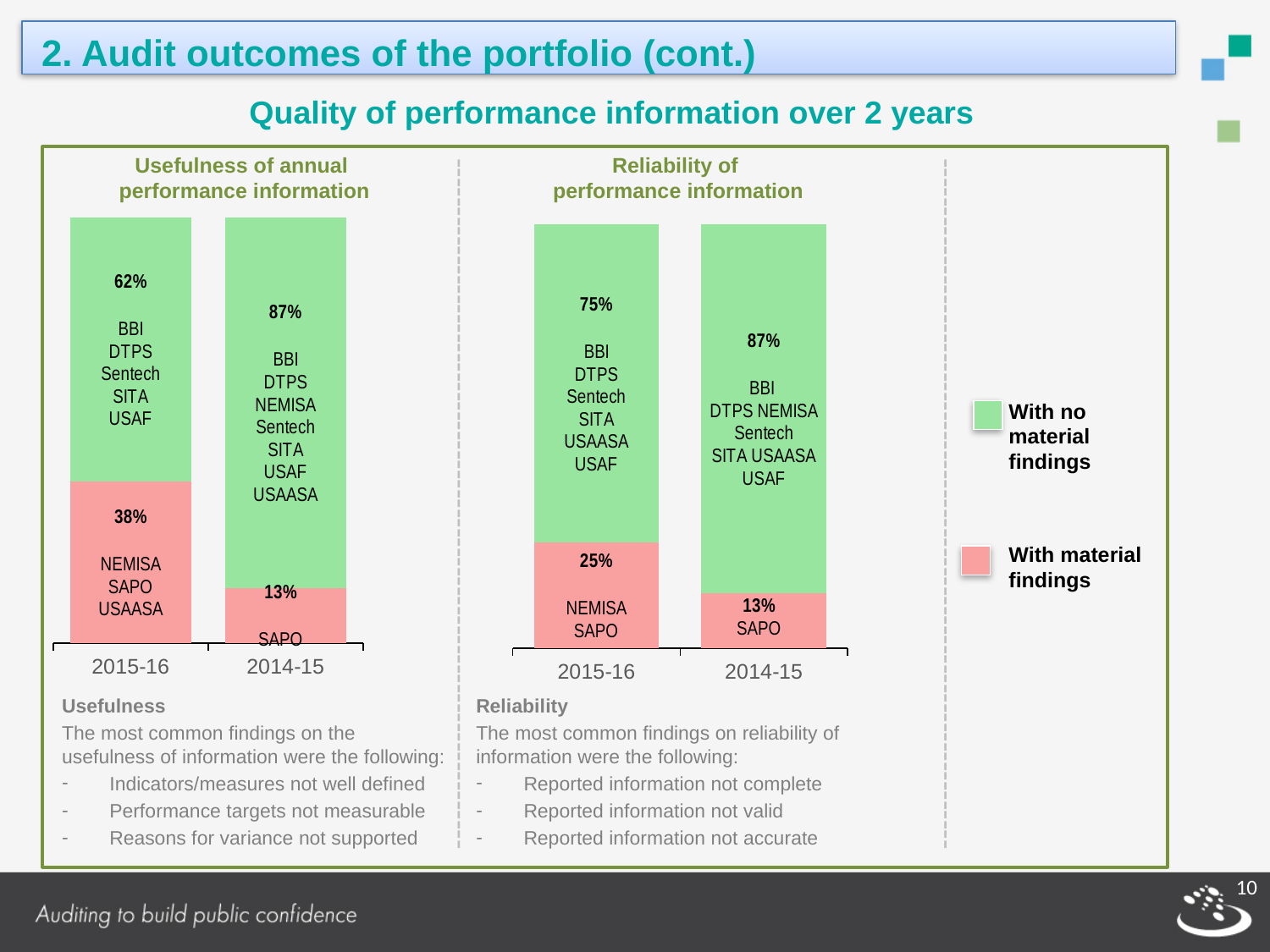
Which colour represents 'With material findings' in the legend? Red (pink) In the 'Reliability of performance information' chart, what percentage had no material findings in 2014-15? 87% In the 'Usefulness of annual performance information' chart, what percentage had material findings in 2014-15? 13% What type of chart is used to show the quality of performance information? Stacked bar chart In the 'Reliability of performance information' chart, what is the difference between the 'With no material findings' shares for 2014-15 and 2015-16? 12 percentage points In the 'Usefulness of annual performance information' chart, by how many percentage points did the share with material findings change from 2014-15 to 2015-16? 25 percentage points In the 'Usefulness of annual performance information' chart, what percentage had no material findings in 2015-16? 62% How many years (categories) are shown in the 'Usefulness of annual performance information' chart? 2 In the 'Usefulness of annual performance information' chart, which year has the larger share with material findings, 2015-16 or 2014-15? 2015-16 In the 'Reliability of performance information' chart, what percentage had material findings in 2015-16? 25% In the 'Reliability of performance information' chart, which year has the higher share with no material findings? 2014-15 How many series does the legend list? 2